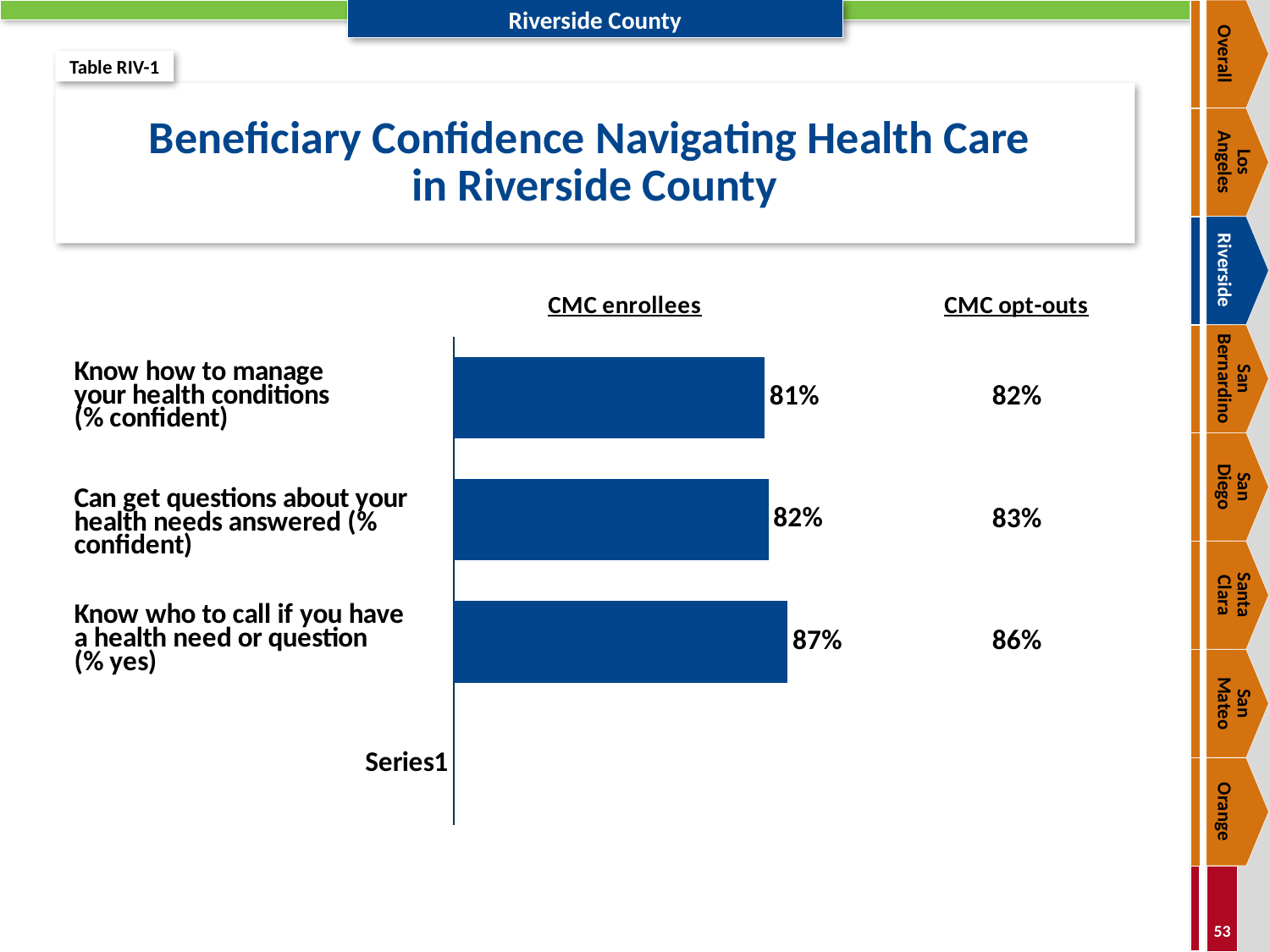
What kind of chart is shown on the slide? Bar chart What is the CMC opt-outs value for "Can get questions about your health needs answered (% confident)"? 83% For "Know how to manage your health conditions", what is the difference between the CMC opt-outs and CMC enrollees values? 1 percentage point What is the difference between the highest and lowest CMC enrollees values? 6 percentage points Which item has the highest CMC enrollees value? Know who to call if you have a health need or question (% yes) Which item has the lowest CMC enrollees value? Know how to manage your health conditions (% confident) What is the CMC opt-outs value for "Know who to call if you have a health need or question (% yes)"? 86% For "Know who to call if you have a health need or question", which group has the larger value, CMC enrollees or CMC opt-outs? CMC enrollees How many bars are plotted in the chart? 3 What is the CMC enrollees value for "Know how to manage your health conditions (% confident)"? 81% What is the title of the chart? Beneficiary Confidence Navigating Health Care in Riverside County What is the CMC enrollees value for "Know who to call if you have a health need or question (% yes)"? 87%